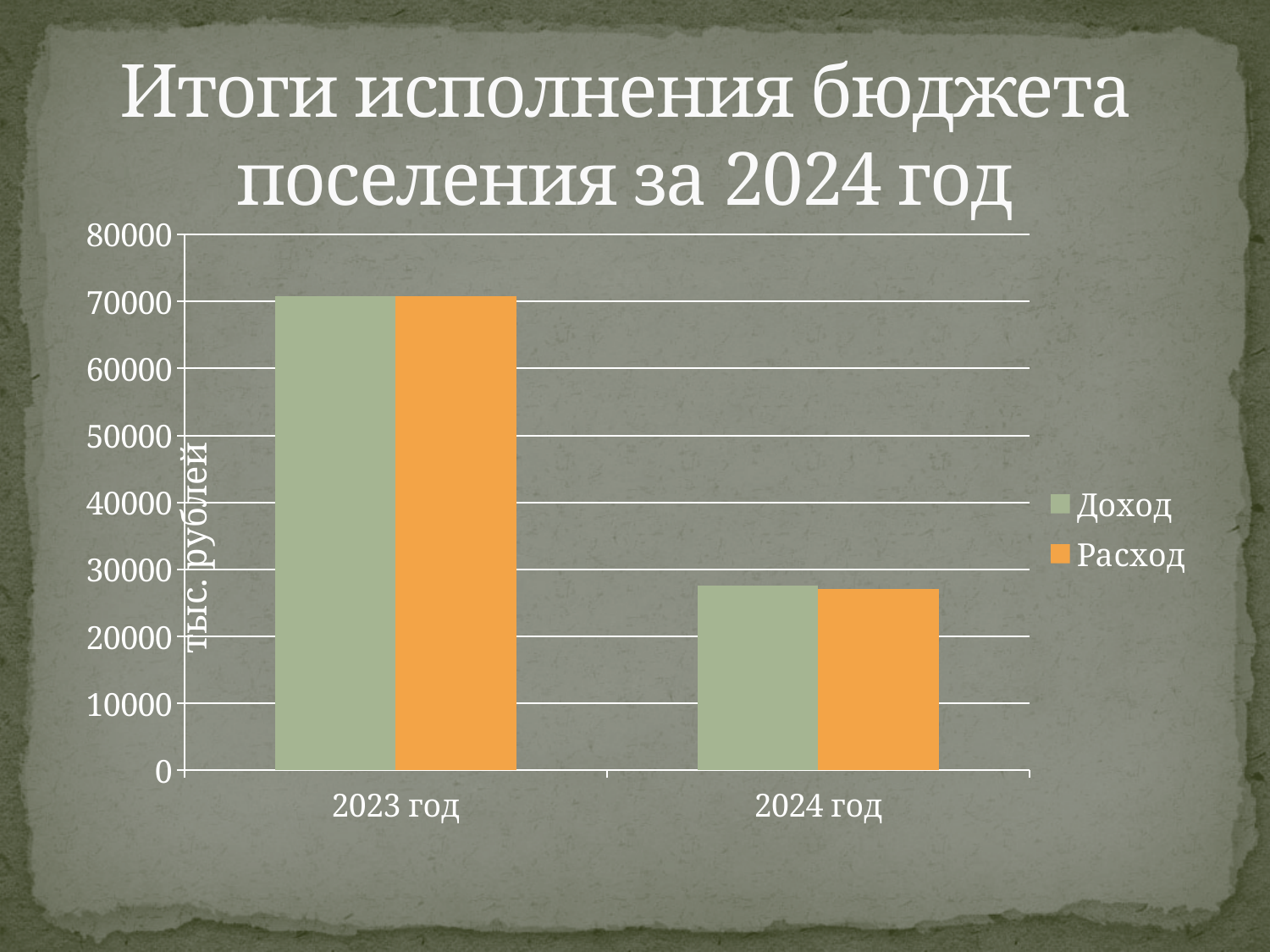
What kind of chart is shown on the slide? bar chart Is the value for Расход in 2024 год greater or less than 20000? greater Is the value for Расход in 2023 год greater or less than 60000? greater Is the value for Доход in 2024 год greater or less than 30000? less Which category has the highest value for Доход? 2023 год Which is larger, Расход in 2023 год or Расход in 2024 год? Расход in 2023 год What are the two series named in the legend? Доход, Расход How many categories are shown on the x axis? 2 What is the title of the chart? Итоги исполнения бюджета поселения за 2024 год Do the values for Доход rise or fall from 2023 год to 2024 год? fall How many series does the legend list? 2